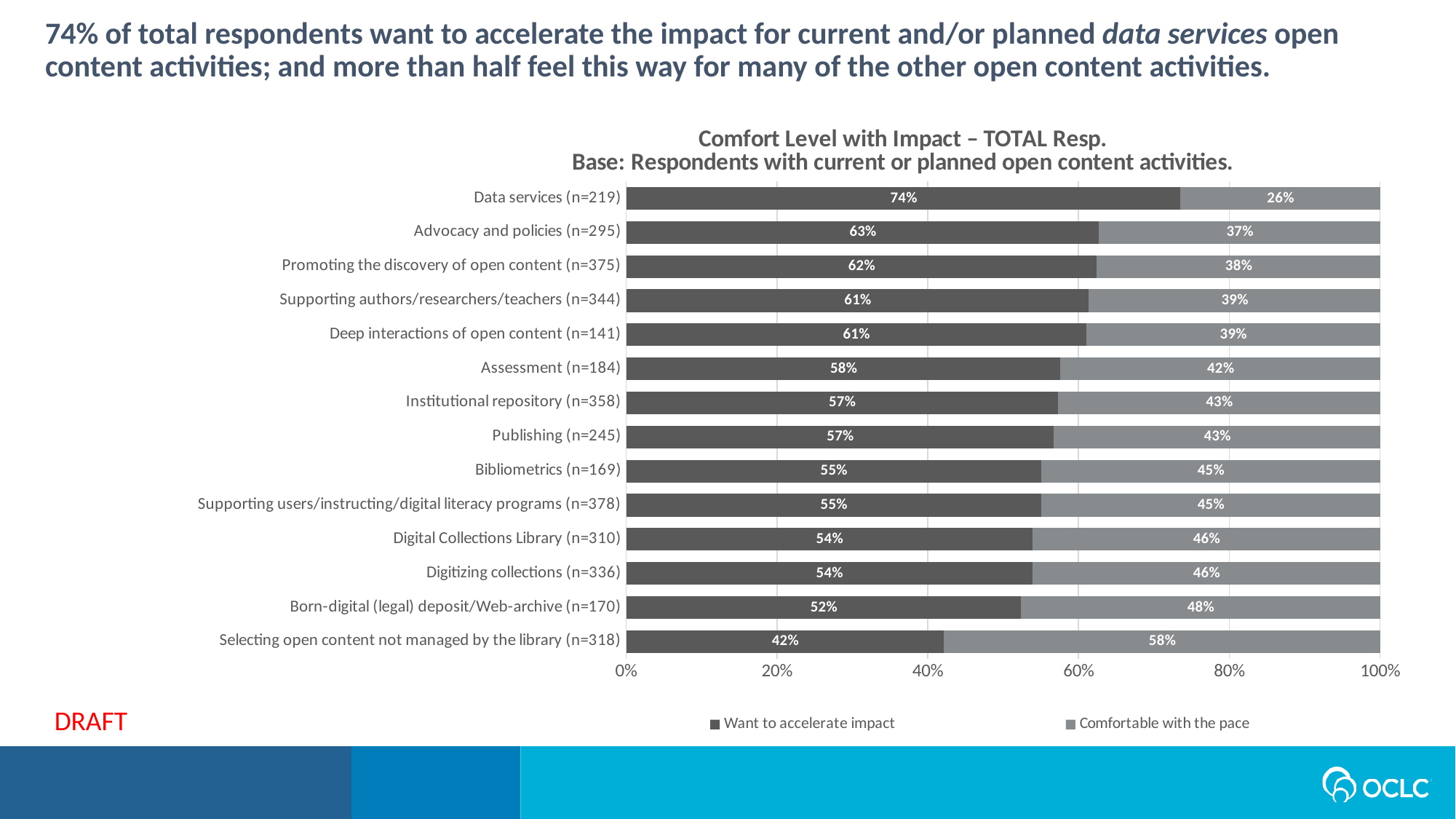
How many series does the legend list? 2 What is the 'Want to accelerate impact' value for Born-digital (legal) deposit/Web-archive (n=170)? 52% Which category has the highest 'Want to accelerate impact' percentage? Data services (n=219) Which has a larger 'Comfortable with the pace' share: Assessment (n=184) or Bibliometrics (n=169)? Bibliometrics (n=169) What is the difference between the 'Want to accelerate impact' values for Data services (n=219) and Advocacy and policies (n=295)? 11% How many categories are shown in the chart? 14 What kind of chart is shown on the slide? Stacked bar chart What is the title of the chart? Comfort Level with Impact – TOTAL Resp. Base: Respondents with current or planned open content activities. Which category has the lowest 'Want to accelerate impact' percentage? Selecting open content not managed by the library (n=318) What is the total of the two segments for the Digitizing collections (n=336) bar? 100% What percentage of respondents for Publishing (n=245) are comfortable with the pace? 43% What percentage of respondents for Data services (n=219) want to accelerate impact? 74%